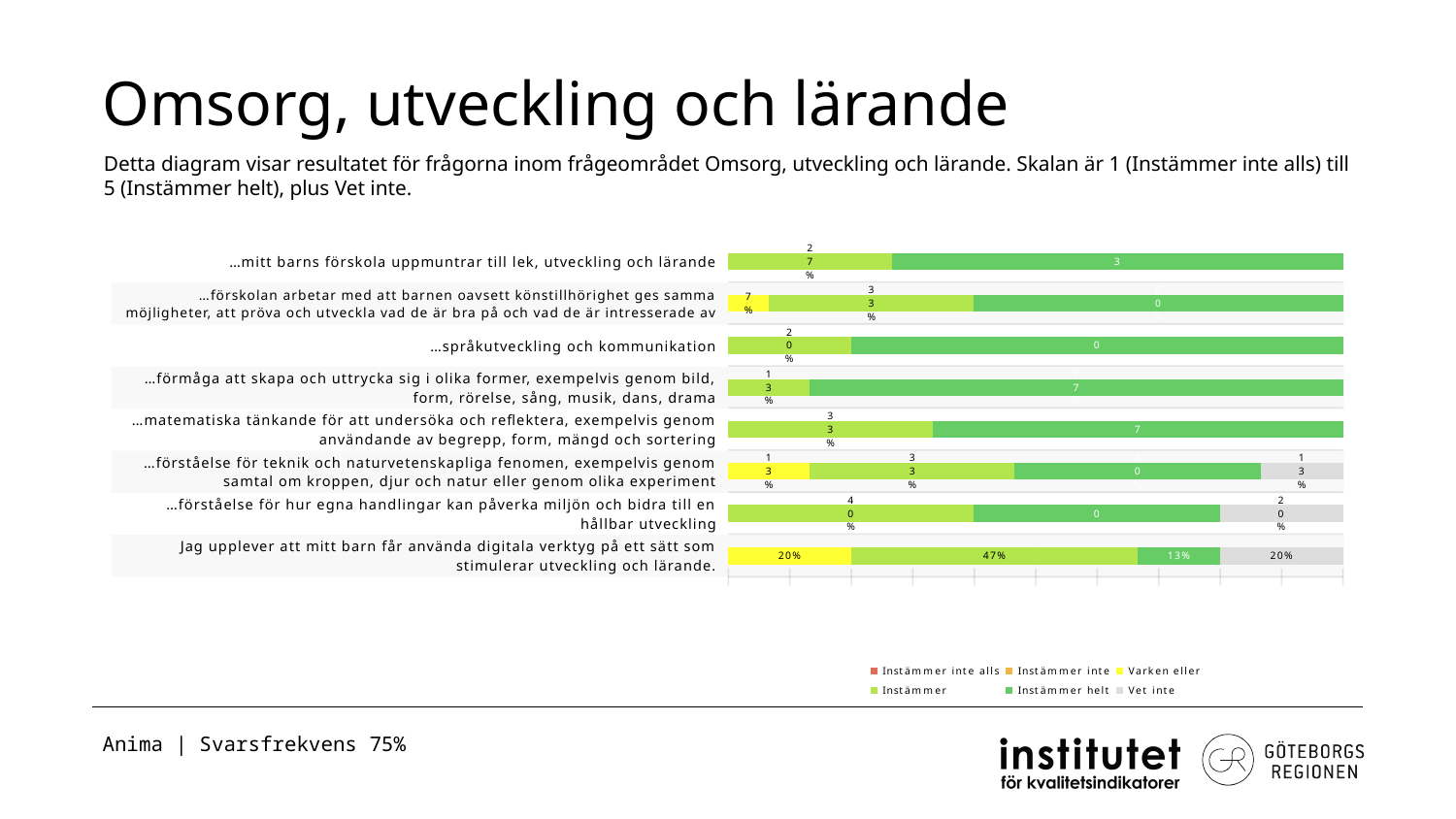
For the statement 'Jag upplever att mitt barn får använda digitala verktyg på ett sätt som stimulerar utveckling och lärande', what share answered 'Instämmer'? 47% For the statement about digitala verktyg, what share answered 'Vet inte'? 20% For the statement about digitala verktyg, which is larger: the 'Instämmer' share or the 'Instämmer helt' share? Instämmer For the statement about digitala verktyg, what share answered 'Varken eller'? 20% How many question statements (categories) are plotted in the chart? 8 Which colour represents 'Vet inte' in the chart legend? Grey For the statement about digitala verktyg, which response category has the largest share? Instämmer For the statement about digitala verktyg, what do the four labelled segments (20%, 47%, 13%, 20%) add up to? 100% For the statement about digitala verktyg, what is the difference between the 'Instämmer' share and the 'Instämmer helt' share? 34 percentage points How many series does the chart legend list? 6 For the statement about digitala verktyg, what share answered 'Instämmer helt'? 13% What kind of chart is shown on the slide? Stacked bar chart